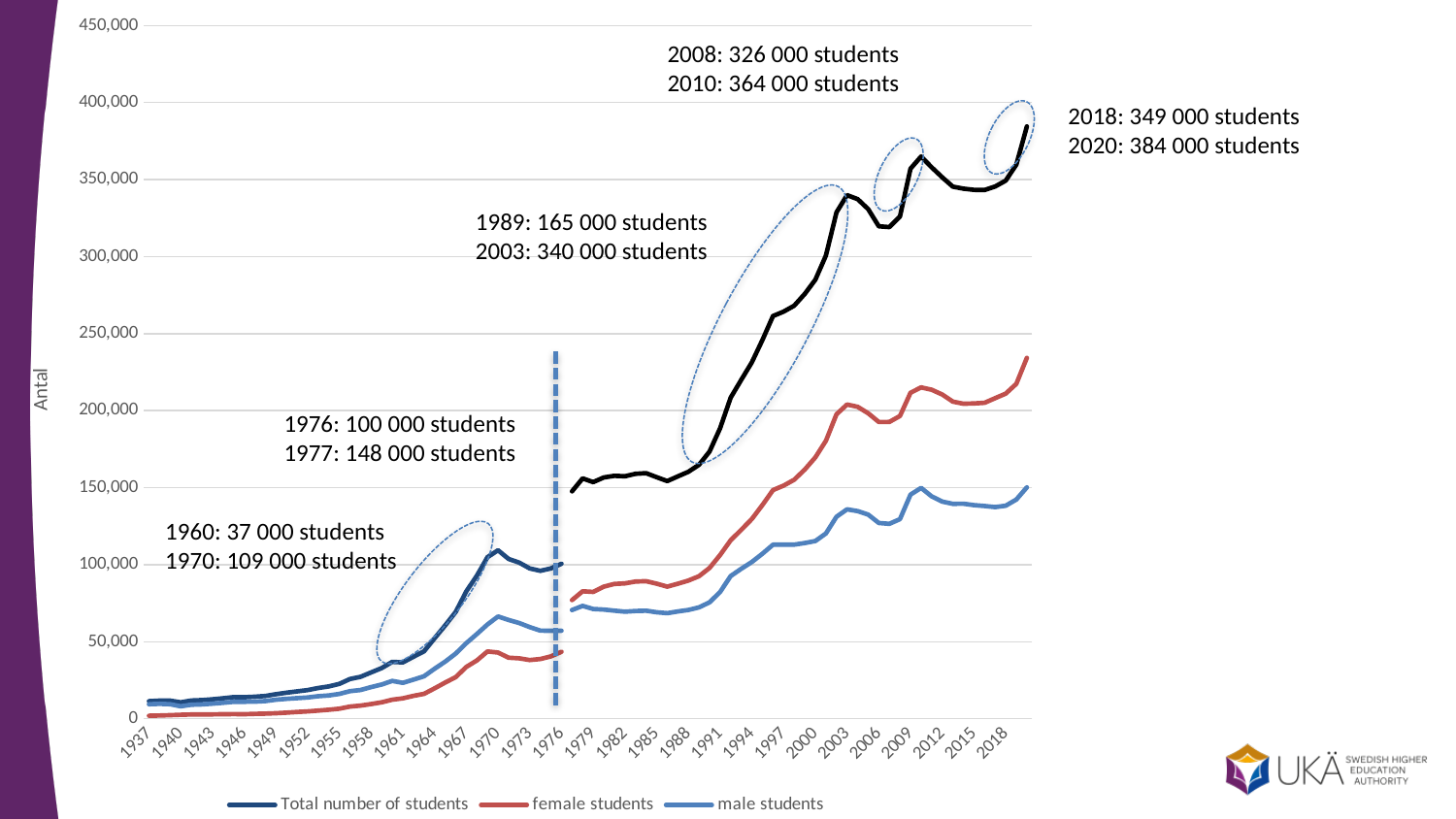
According to the annotations, by how much did the number of students increase from 1976 to 1977? 48 000 students What is the label on the vertical axis? Antal Overall, does the total number of students rise or fall from 1937 to 2018? Rise According to the annotation, how many students were there in 2003? 340 000 students Is the value for male students in 2018 greater or less than 200,000? less According to the annotation, how many students were there in 2020? 384 000 students How many series does the legend list? 3 In 2018, which is larger: the number of female students or the number of male students? Female students According to the annotations, what is the difference in the number of students between 2018 and 2020? 35 000 students What kind of chart is shown on the slide? Line chart According to the annotation, how many students were there in 1960? 37 000 students Is the value for female students in 2018 greater or less than 200,000? greater